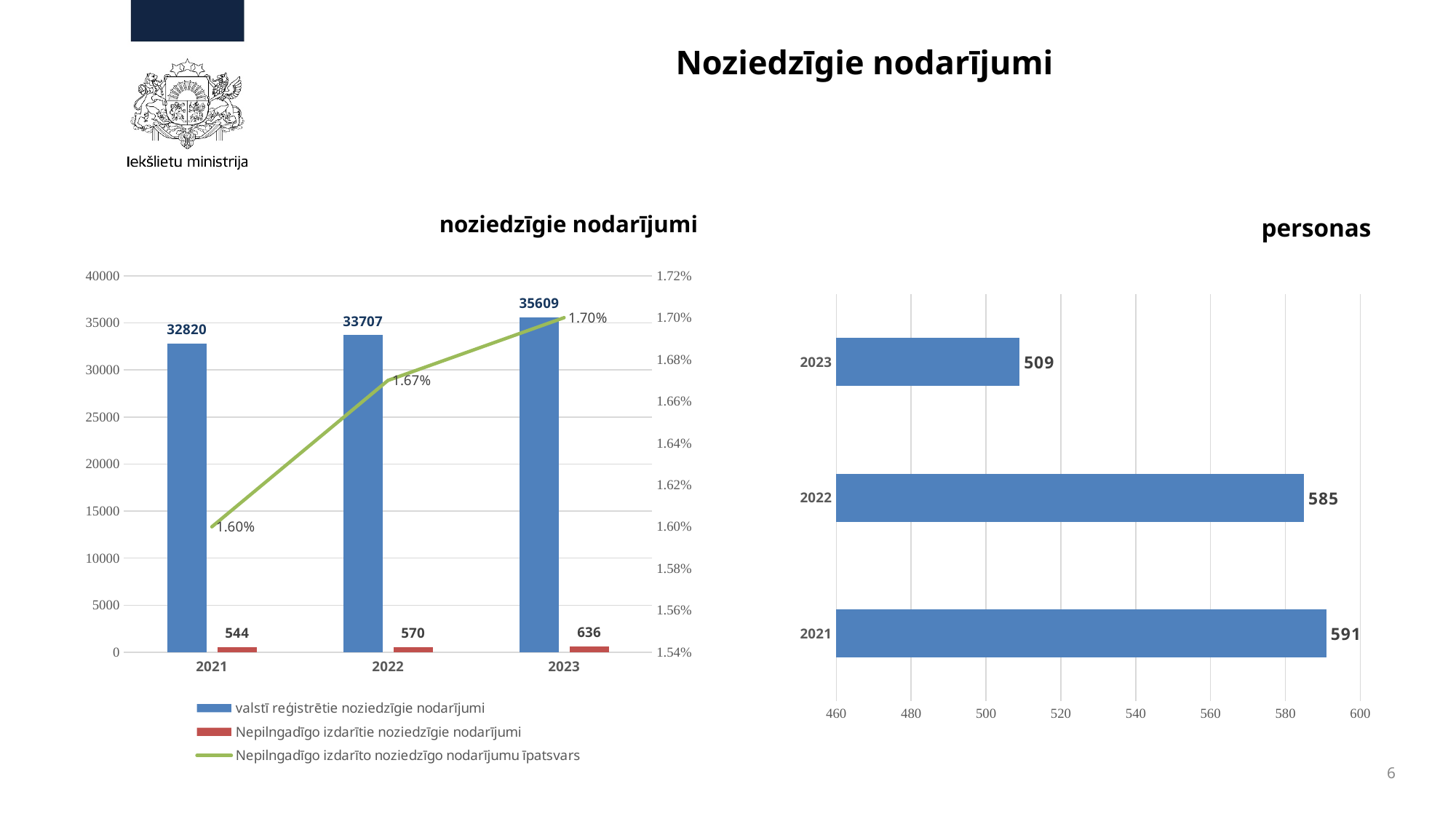
In the 'noziedzīgie nodarījumi' chart, how many series does the legend list? 3 In the 'noziedzīgie nodarījumi' chart, what is the 'Nepilngadīgo izdarīto noziedzīgo nodarījumu īpatsvars' value for 2021? 1.60% In the 'noziedzīgie nodarījumi' chart, does the 'Nepilngadīgo izdarīto noziedzīgo nodarījumu īpatsvars' line rise or fall from 2021 to 2023? rise In the 'personas' chart, what is the value for 2022? 585 What kind of chart is the 'personas' chart? bar chart In the 'noziedzīgie nodarījumi' chart, what is the value of 'Nepilngadīgo izdarītie noziedzīgie nodarījumi' for 2023? 636 In the 'personas' chart, which year has the lowest value? 2023 In the 'noziedzīgie nodarījumi' chart, what is the difference between the 'Nepilngadīgo izdarītie noziedzīgie nodarījumi' values for 2023 and 2021? 92 In the 'personas' chart, what is the difference between the values for 2021 and 2023? 82 In the 'noziedzīgie nodarījumi' chart, what is the value of 'valstī reģistrētie noziedzīgie nodarījumi' for 2022? 33707 In the 'personas' chart, how many years are shown? 3 In the 'noziedzīgie nodarījumi' chart, which year has the highest value of 'valstī reģistrētie noziedzīgie nodarījumi'? 2023